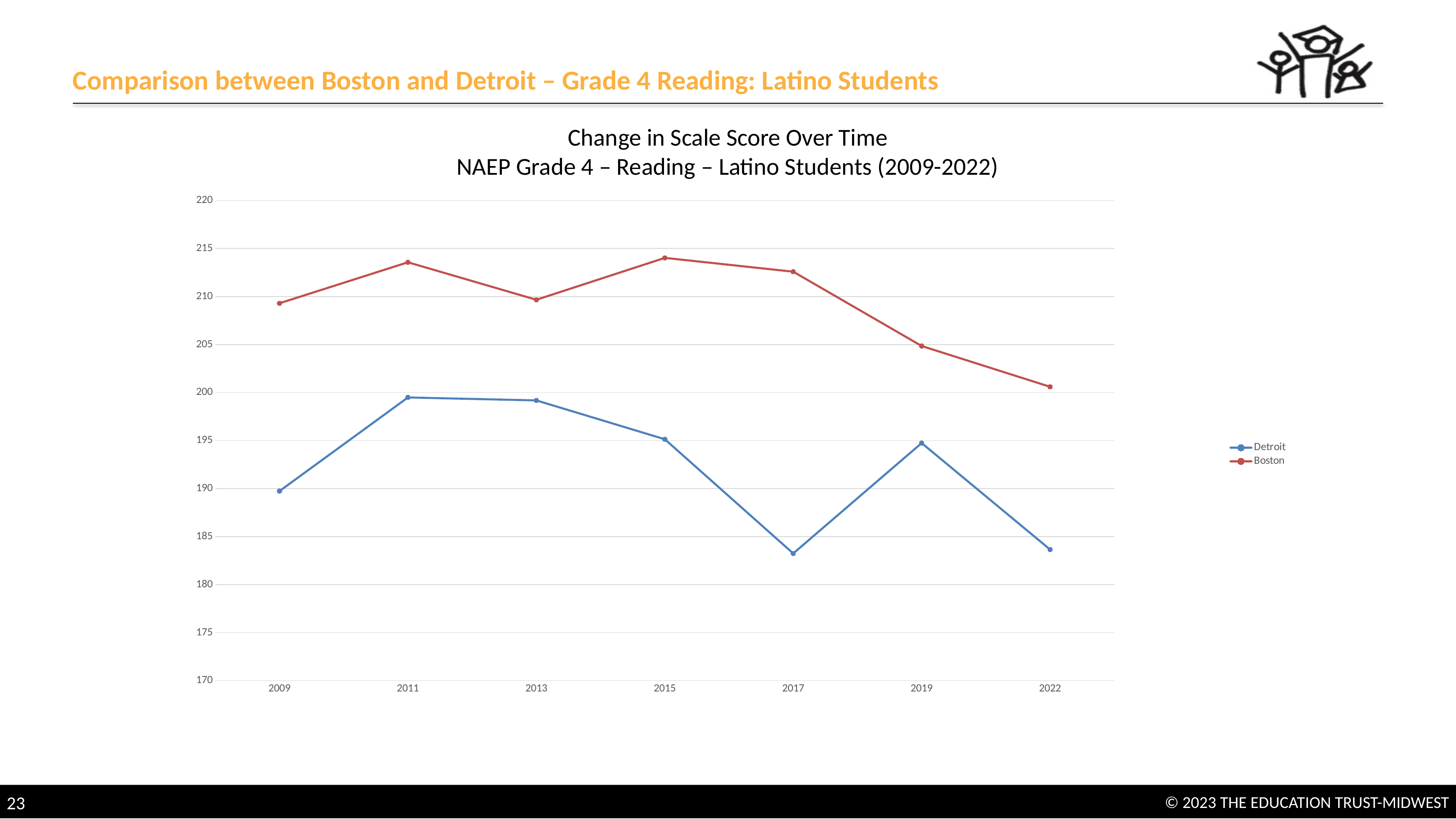
What colour is the line for Boston? Red In which year is the Boston series at its lowest? 2022 Is the value for Detroit in 2017 greater or less than 185? less How many years are plotted along the x axis? 7 What kind of chart is shown on the slide? Line chart Which series has the higher value in 2022, Detroit or Boston? Boston Is the value for Boston in 2011 greater or less than 210? greater Does the Boston series rise or fall from 2015 to 2022? Fall For Detroit, which year has the higher value, 2011 or 2017? 2011 How many series does the legend list? 2 Is the value for Detroit in 2022 greater or less than 185? less